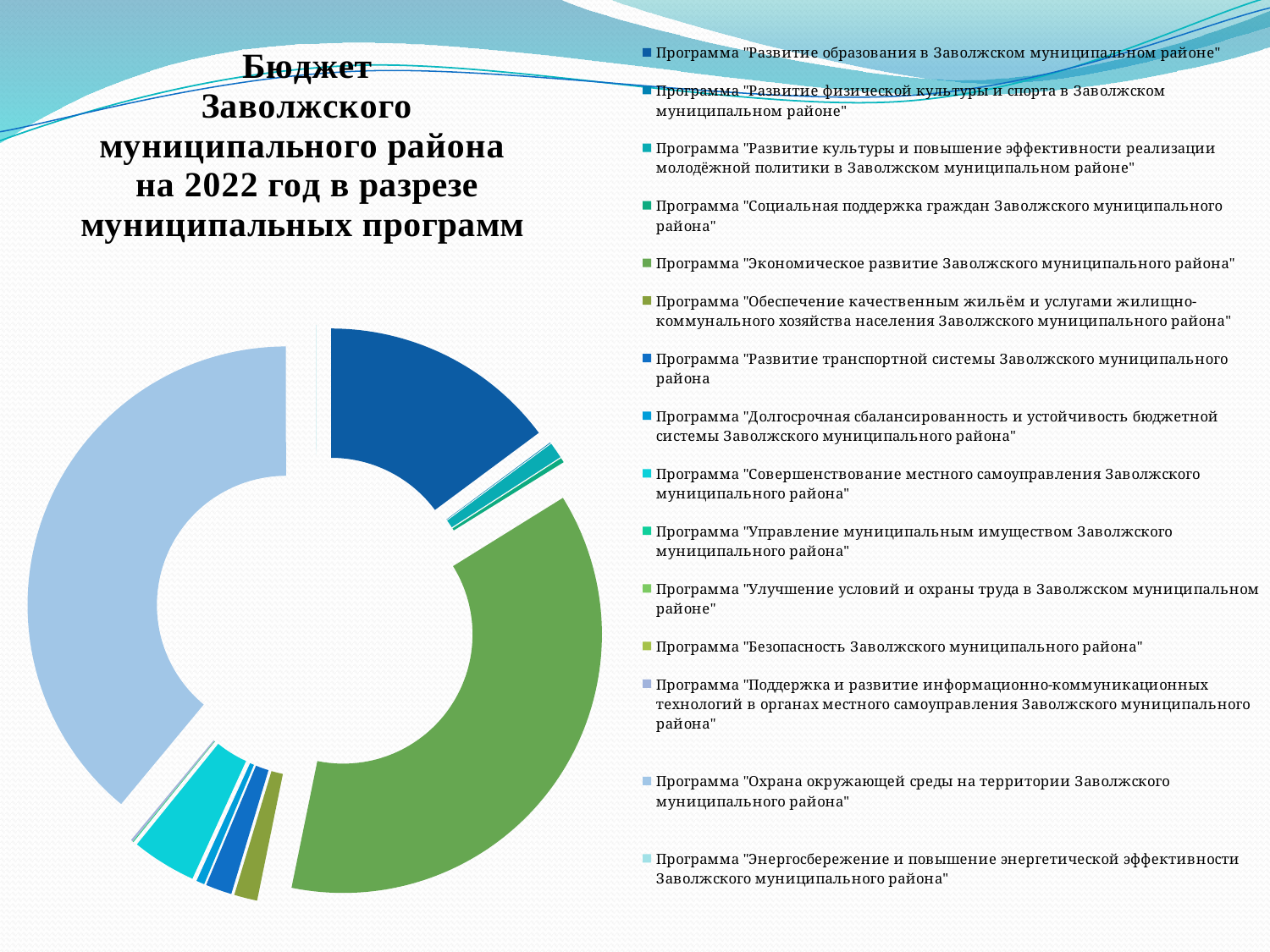
How many programmes does the legend of the chart list? 15 Which programme is listed first in the chart legend? Программа "Развитие образования в Заволжском муниципальном районе" Does the largest green slice take up more or less than 25% of the doughnut? more What is the title of the slide containing the chart? Бюджет Заволжского муниципального района на 2022 год в разрезе муниципальных программ Is the slice for Программа "Развитие образования в Заволжском муниципальном районе" larger or smaller than the large green slice? smaller What kind of chart is shown on the slide? doughnut (pie) chart How many slices does the doughnut chart have? 15 Does the slice for Программа "Развитие образования в Заволжском муниципальном районе" take up more or less than 25% of the doughnut? less